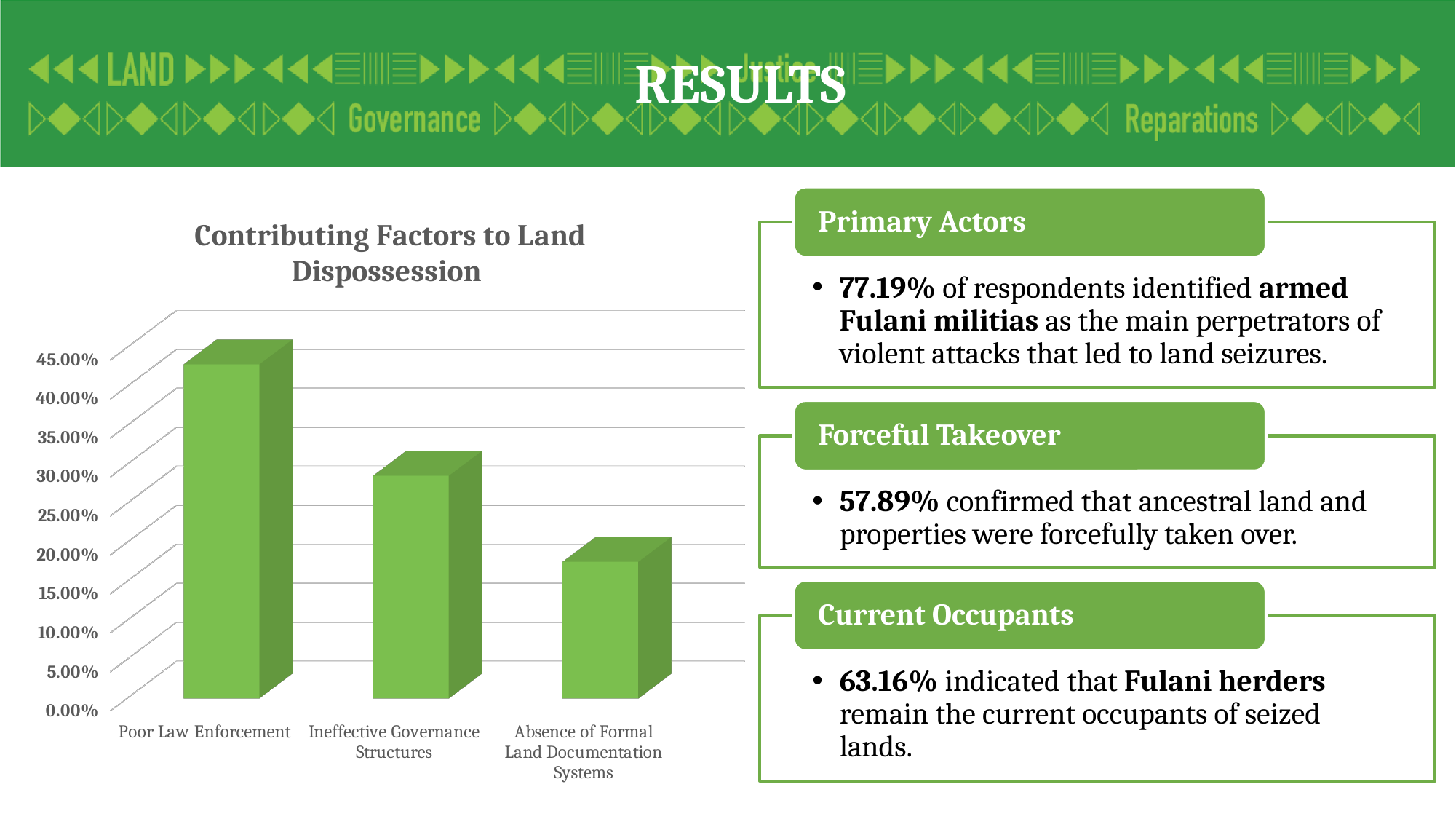
What type of chart is shown on the slide? Bar chart Is the value for Absence of Formal Land Documentation Systems greater or less than 15.00%? greater Which category has the highest value in the chart? Poor Law Enforcement Which category has the lowest value in the chart? Absence of Formal Land Documentation Systems How many categories are plotted in the chart? 3 Is the value for Ineffective Governance Structures greater or less than 25.00%? greater Is the value for Poor Law Enforcement greater or less than 40.00%? greater What is the highest tick label shown on the vertical axis of the chart? 45.00% What is the title of the chart? Contributing Factors to Land Dispossession Do the bar values rise or fall from left to right across the categories? Fall Which is larger: the value for Ineffective Governance Structures or the value for Absence of Formal Land Documentation Systems? Ineffective Governance Structures